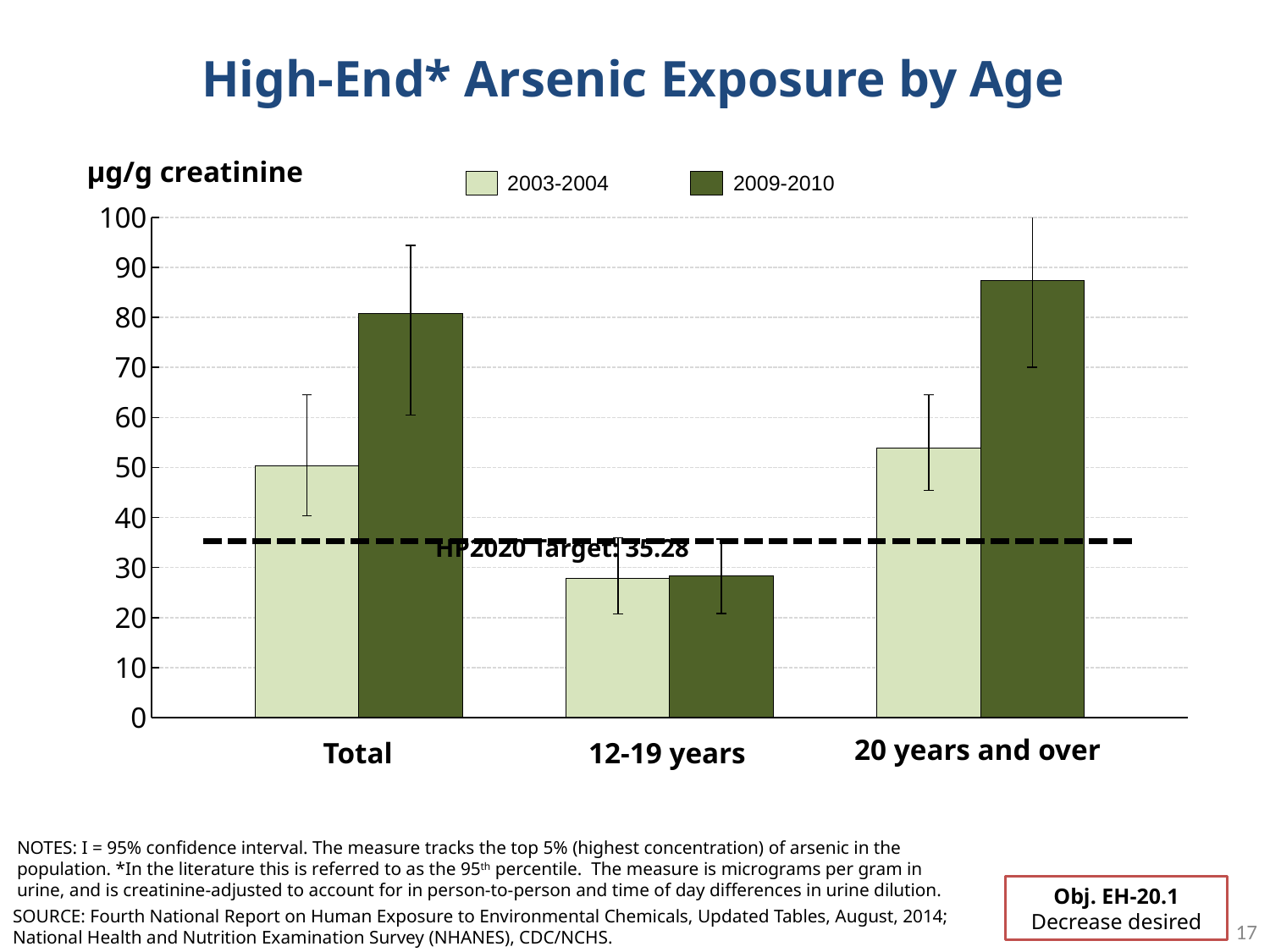
For 20 years and over, which series has the larger value, 2003-2004 or 2009-2010? 2009-2010 Which category has the highest value for 2009-2010? 20 years and over Is the 2009-2010 value for Total greater or less than 70? greater How many series does the legend list? 2 For the Total category, which series has the larger value, 2003-2004 or 2009-2010? 2009-2010 Is the 2003-2004 value for 12-19 years greater or less than 30? less How many age categories are shown on the x axis? 3 Which category has the lowest value for 2003-2004? 12-19 years What kind of chart is shown on the slide? bar chart Is the 2003-2004 value for Total greater or less than 60? less Which category has the lowest value for 2009-2010? 12-19 years What is the HP2020 target value shown by the dashed line? 35.28